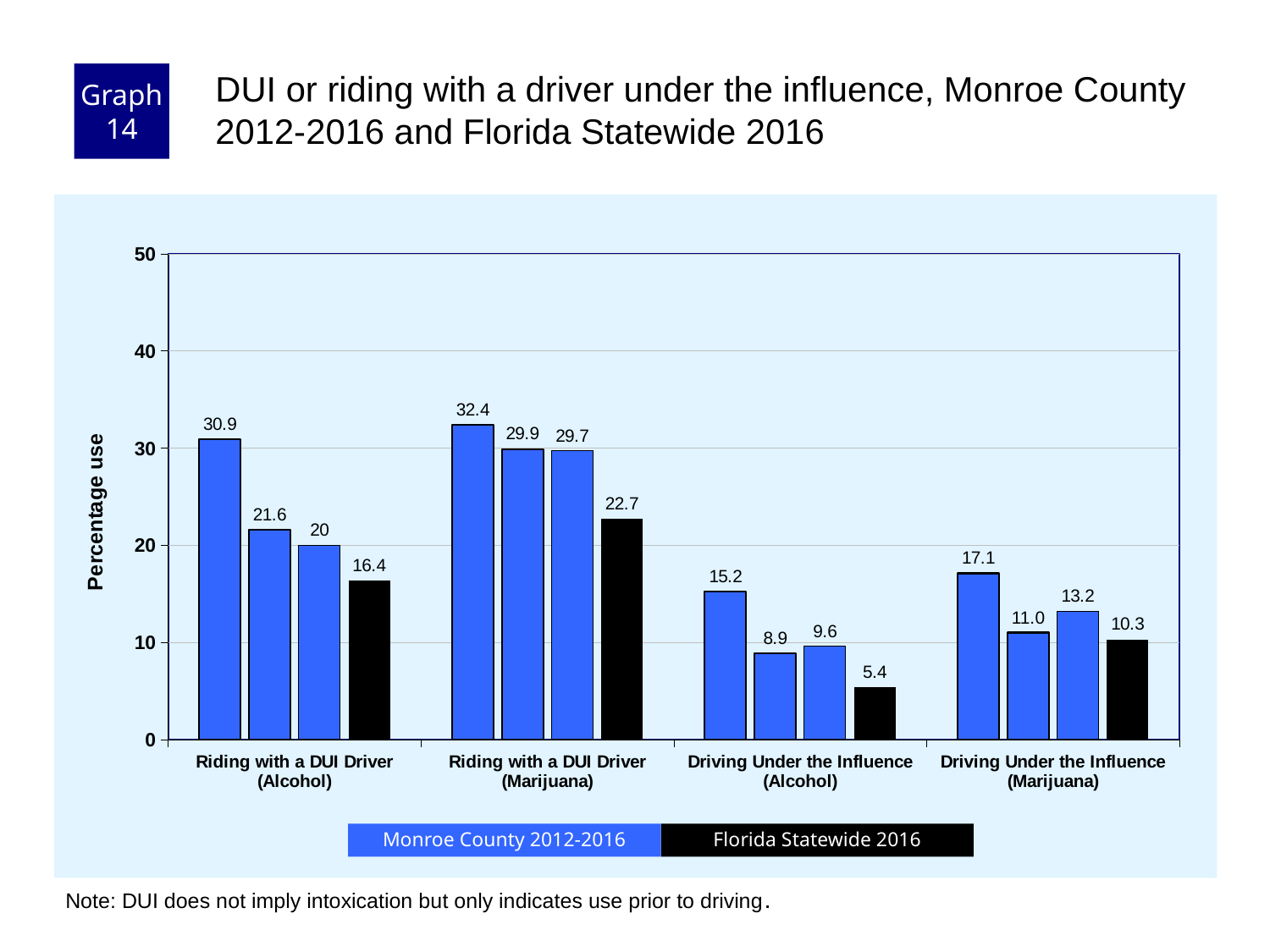
Which is larger: the Florida Statewide 2016 value for Riding with a DUI Driver (Alcohol) or for Driving Under the Influence (Marijuana)? Riding with a DUI Driver (Alcohol) What is the value of the Florida Statewide 2016 bar for Driving Under the Influence (Alcohol)? 5.4 What kind of chart is shown on the slide? bar chart What is the difference between the first Monroe County bar (30.9) and the Florida Statewide 2016 bar (16.4) for Riding with a DUI Driver (Alcohol)? 14.5 How many series does the legend list? 2 What is the value of the Florida Statewide 2016 bar for Riding with a DUI Driver (Alcohol)? 16.4 How many categories are shown on the x axis? 4 What is the value of the first (leftmost) Monroe County bar for Riding with a DUI Driver (Marijuana)? 32.4 Which category has the highest Florida Statewide 2016 value? Riding with a DUI Driver (Marijuana) Which category has the lowest Florida Statewide 2016 value? Driving Under the Influence (Alcohol) Is the Florida Statewide 2016 value for Riding with a DUI Driver (Marijuana) greater or less than 20? greater What is the value of the Florida Statewide 2016 bar for Driving Under the Influence (Marijuana)? 10.3